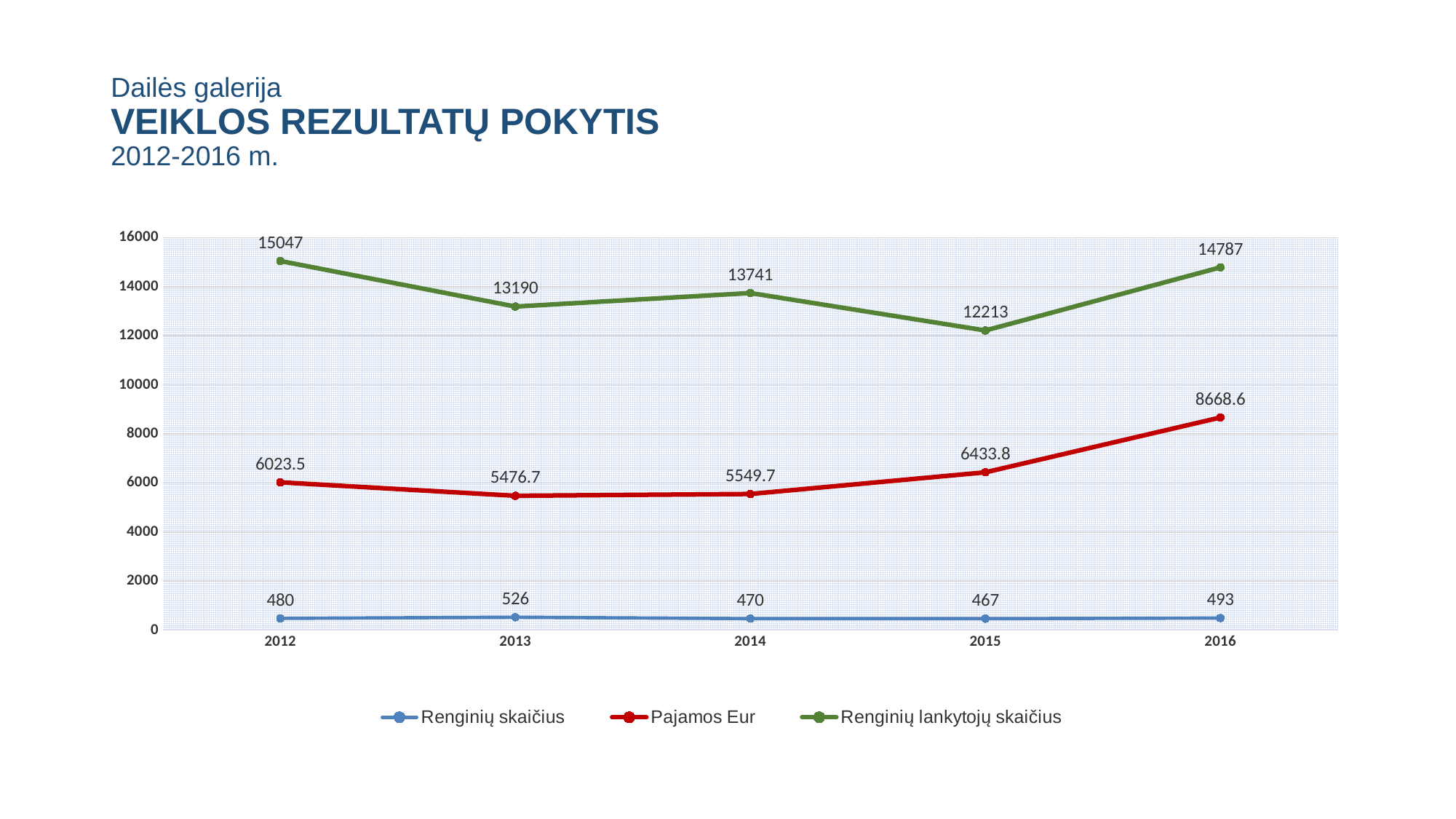
What is the difference between Pajamos Eur in 2016 and in 2015? 2234.8 In which year is Renginių skaičius lowest? 2015 In which year is Renginių lankytojų skaičius lowest? 2015 What kind of chart is shown on the slide? line chart Which is larger: Renginių lankytojų skaičius in 2014 or in 2016? 2016 What is the difference between Renginių lankytojų skaičius in 2012 and in 2013? 1857 What is the value of Renginių lankytojų skaičius in 2012? 15047 What is the value of Renginių skaičius in 2013? 526 How many series does the legend list? 3 What is the value of Pajamos Eur in 2016? 8668.6 How many years are shown on the x axis? 5 In which year is Pajamos Eur highest? 2016